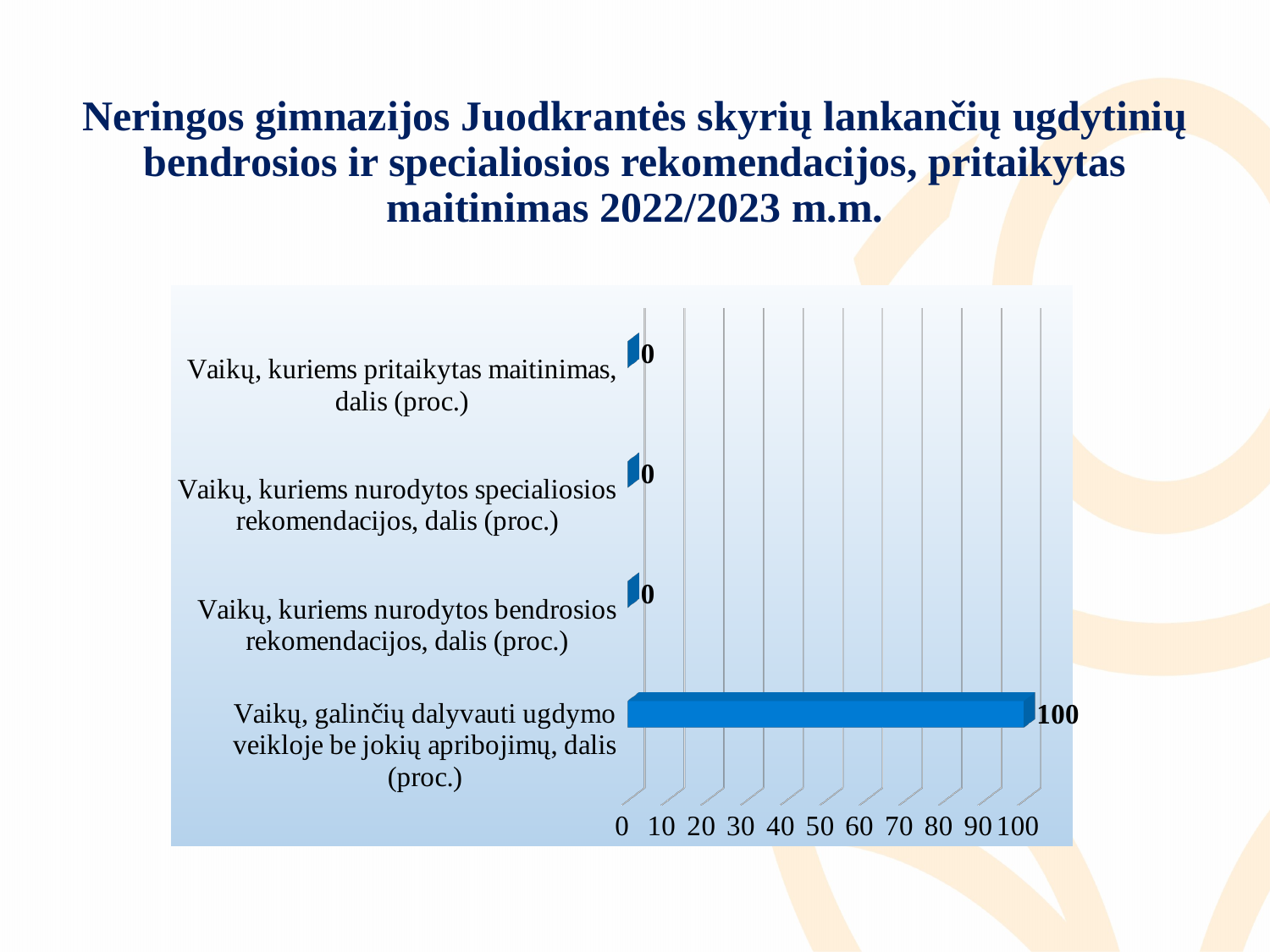
What is the value for "Vaikų, kuriems nurodytos specialiosios rekomendacijos, dalis (proc.)"? 0 Which category has the highest value? Vaikų, galinčių dalyvauti ugdymo veikloje be jokių apribojimų, dalis (proc.) What is the value for "Vaikų, kuriems nurodytos bendrosios rekomendacijos, dalis (proc.)"? 0 What is the value for "Vaikų, galinčių dalyvauti ugdymo veikloje be jokių apribojimų, dalis (proc.)"? 100 What is the value for "Vaikų, kuriems pritaikytas maitinimas, dalis (proc.)"? 0 What is the highest value shown on the horizontal axis of the chart? 100 Is the value for "Vaikų, galinčių dalyvauti ugdymo veikloje be jokių apribojimų, dalis (proc.)" greater or less than 50? greater Which is larger: the value for "Vaikų, galinčių dalyvauti ugdymo veikloje be jokių apribojimų, dalis (proc.)" or the value for "Vaikų, kuriems nurodytos bendrosios rekomendacijos, dalis (proc.)"? Vaikų, galinčių dalyvauti ugdymo veikloje be jokių apribojimų, dalis (proc.) What is the difference between the value for "Vaikų, galinčių dalyvauti ugdymo veikloje be jokių apribojimų, dalis (proc.)" and the value for "Vaikų, kuriems pritaikytas maitinimas, dalis (proc.)"? 100 How many categories are shown in the chart? 4 What kind of chart is shown on the slide? bar chart How many categories in the chart have a value of 0? 3